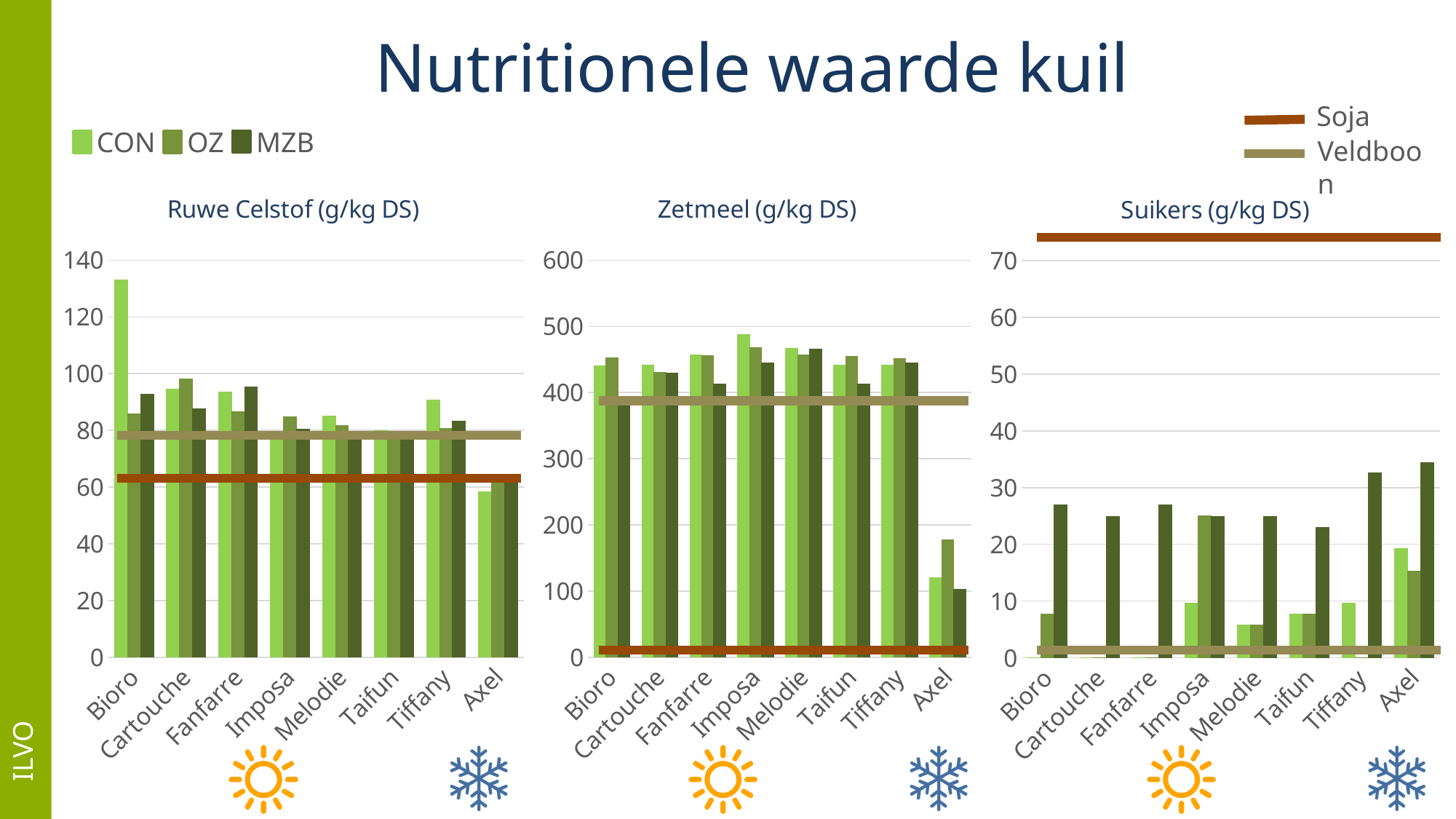
In the Zetmeel (g/kg DS) chart, which category has the lowest bars? Axel In the Suikers (g/kg DS) chart, is the MZB value for Axel greater or less than 30? greater What is the title of the slide? Nutritionele waarde kuil In the Suikers (g/kg DS) chart, which is larger for Bioro: the CON bar or the MZB bar? MZB In the Ruwe Celstof (g/kg DS) chart, is the CON value for Bioro greater or less than 120? greater In the Zetmeel (g/kg DS) chart, which category has the highest CON bar? Imposa How many series does the CON/OZ/MZB legend list? 3 How many categories are shown on the x axis of the Zetmeel (g/kg DS) chart? 8 What kind of chart is the Ruwe Celstof (g/kg DS) chart? bar chart In the Ruwe Celstof (g/kg DS) chart, which category has the highest CON bar? Bioro In the Zetmeel (g/kg DS) chart, is the CON value for Axel greater or less than 200? less In the Ruwe Celstof (g/kg DS) chart, which is larger for Cartouche: the OZ bar or the MZB bar? OZ